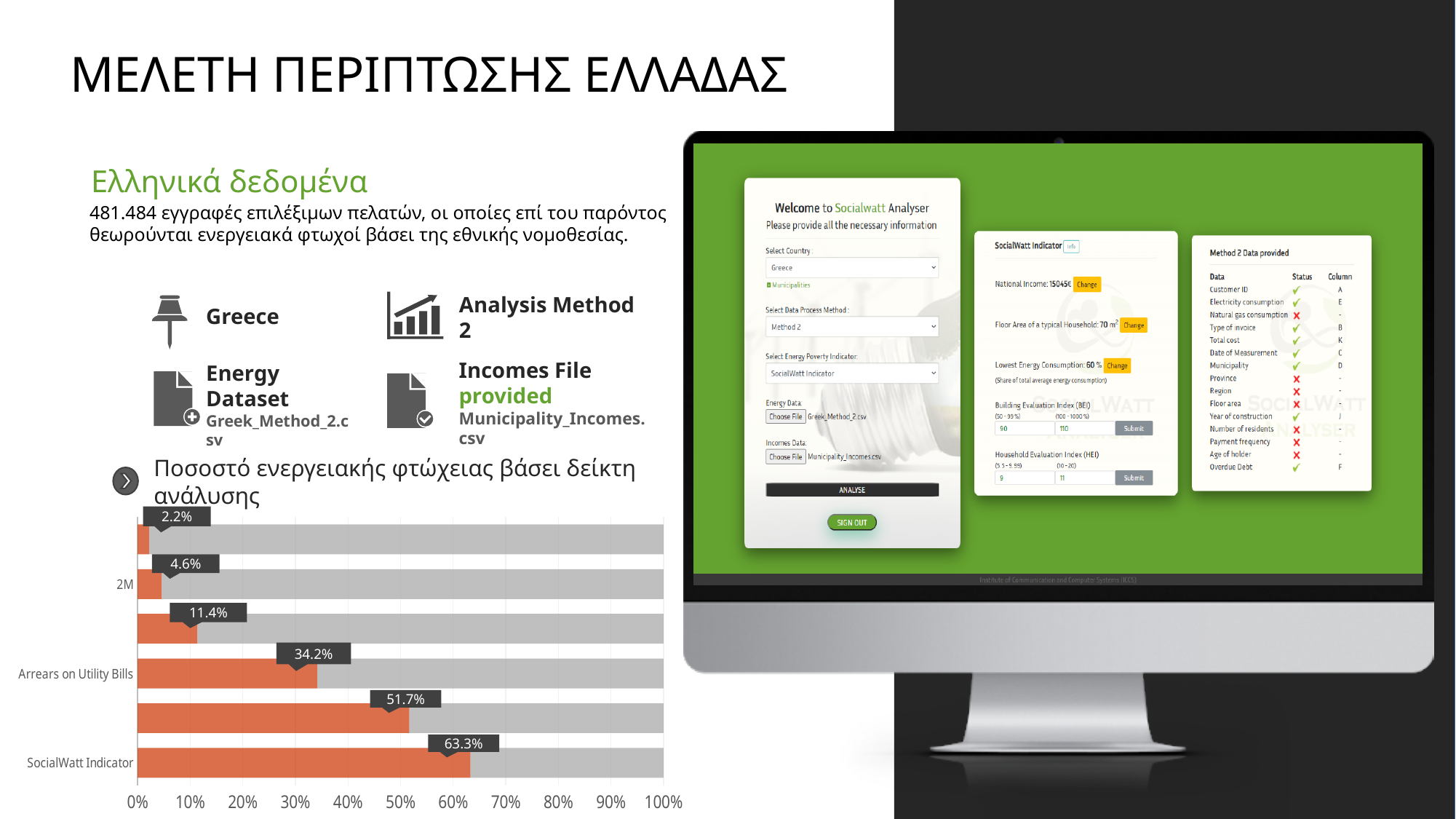
What is the value for Arrears on Utility Bills in the bar chart? 34.2% What is the value for 2M in the bar chart? 4.6% What is the smallest value shown in the bar chart? 2.2% Which is larger, the value for Arrears on Utility Bills or the value for 2M? Arrears on Utility Bills What is the title of the bar chart? Ποσοστό ενεργειακής φτώχειας βάσει δείκτη ανάλυσης What is the value for SocialWatt Indicator in the bar chart? 63.3% What is the difference between the values for Arrears on Utility Bills and 2M? 29.6% What is the difference between the values for SocialWatt Indicator and Arrears on Utility Bills? 29.1% Which category has the highest value in the bar chart? SocialWatt Indicator What kind of chart is shown on the slide? bar chart How many bars are shown in the chart? 6 Is the value for SocialWatt Indicator greater or less than 50%? greater